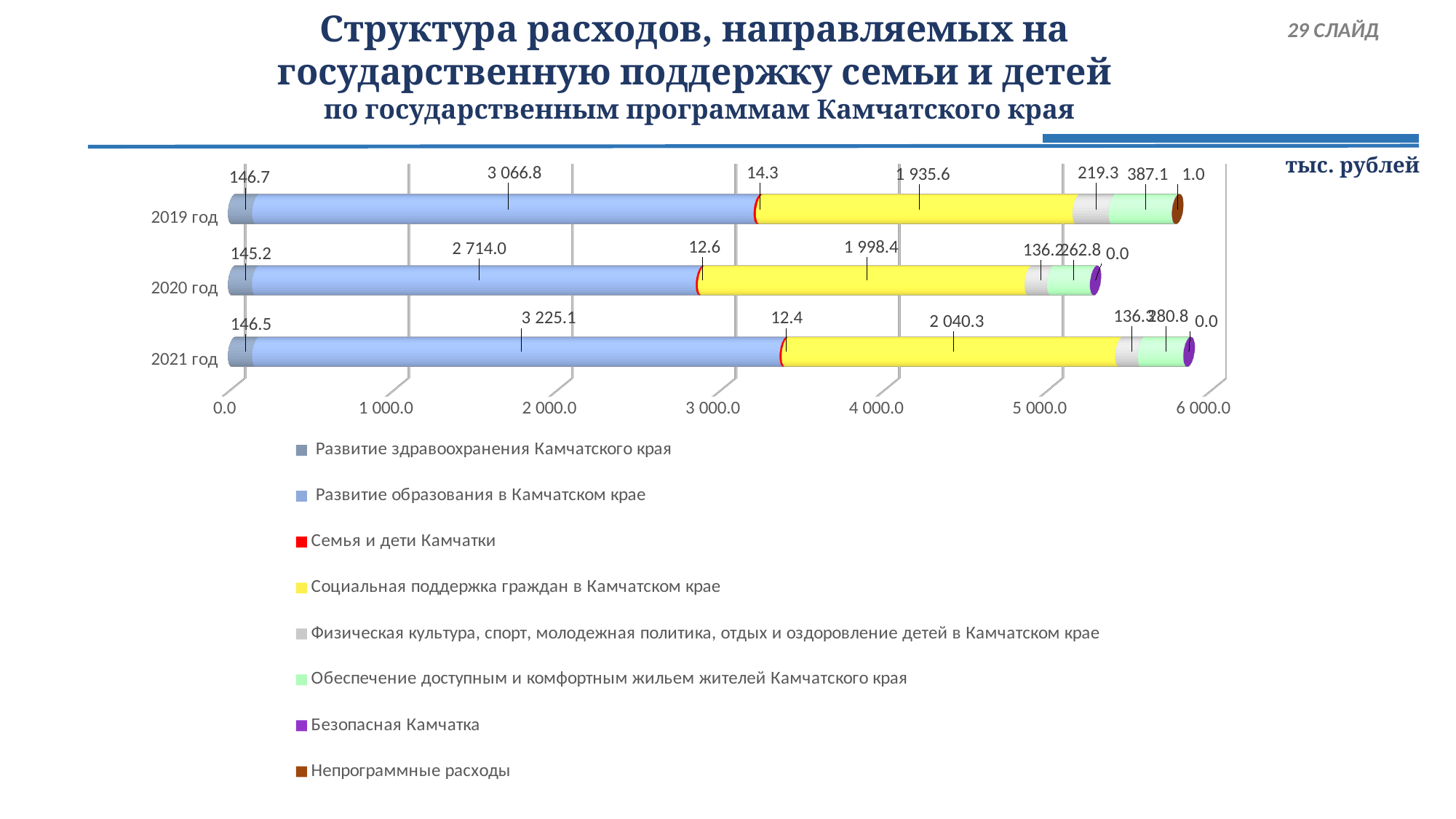
In which year is the value for «Развитие образования в Камчатском крае» the highest? 2021 год Is the total length of the 2019 год bar greater or less than 5 000.0? greater What is the value for «Развитие образования в Камчатском крае» in 2021 год? 3 225.1 In which year is the value for «Социальная поддержка граждан в Камчатском крае» the lowest? 2019 год What is the difference between the «Развитие образования в Камчатском крае» values for 2021 год and 2020 год? 511.1 How many series does the legend list? 8 Which is larger: the «Развитие образования в Камчатском крае» value for 2019 год or for 2020 год? 2019 год How many years are shown on the chart? 3 What is the value for «Социальная поддержка граждан в Камчатском крае» in 2019 год? 1 935.6 What is the value for «Развитие здравоохранения Камчатского края» in 2020 год? 145.2 What is the value for «Семья и дети Камчатки» in 2021 год? 12.4 Does the value for «Социальная поддержка граждан в Камчатском крае» rise or fall from 2019 год to 2021 год? rise